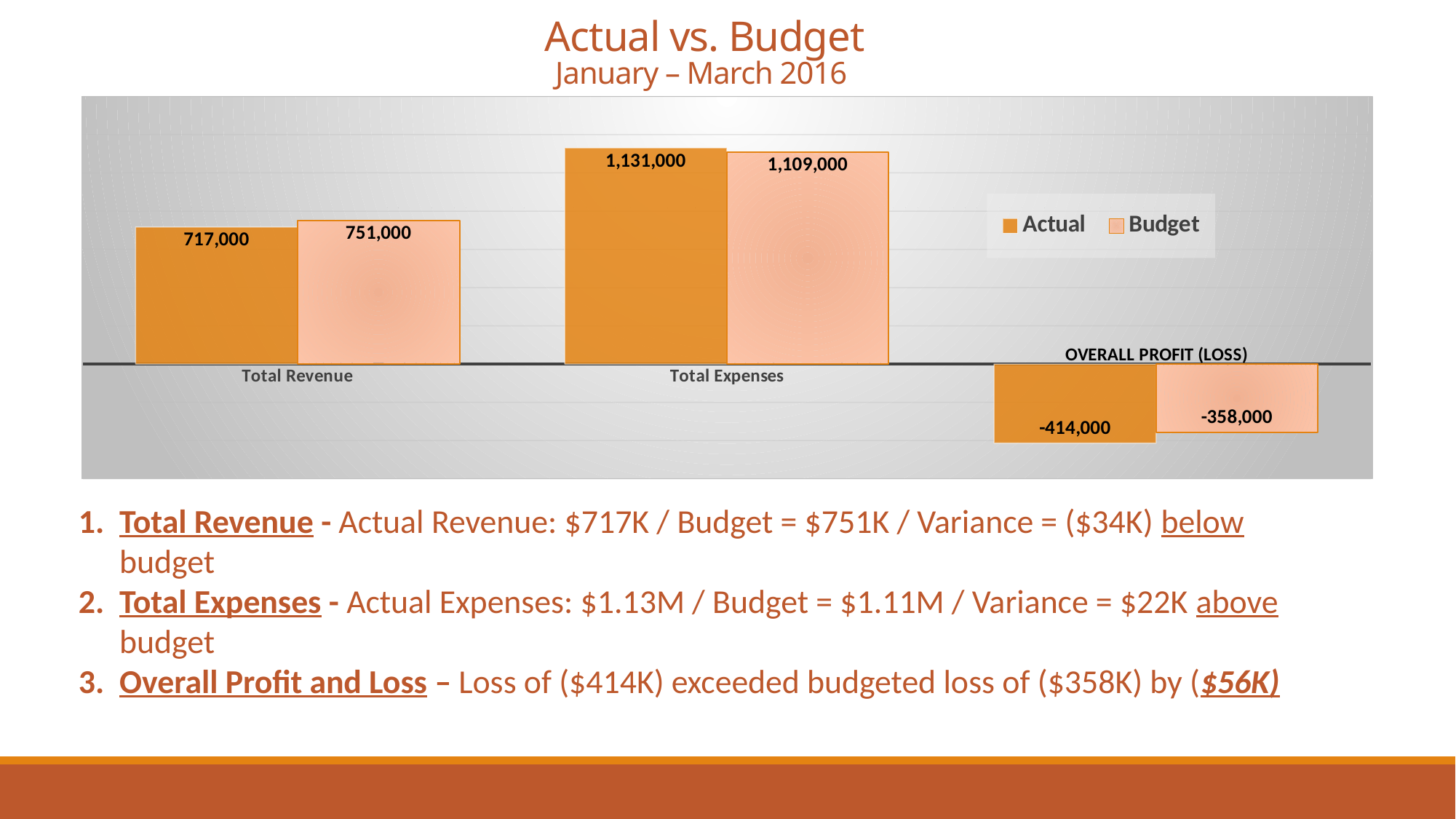
What is the Budget value for OVERALL PROFIT (LOSS)? -358,000 Which category has the highest Actual value? Total Expenses What is the Actual value for OVERALL PROFIT (LOSS)? -414,000 What is the Budget value for Total Expenses? 1,109,000 For Total Revenue, which is larger: the Actual value or the Budget value? Budget Which category has the lowest Budget value? OVERALL PROFIT (LOSS) What is the Actual value for Total Revenue? 717,000 What is the difference between the Actual and Budget values for Total Expenses? 22,000 What is the difference between the Budget and Actual values for Total Revenue? 34,000 How many categories are shown on the x axis? 3 What kind of chart is shown on the slide? Bar chart How many series does the legend list? 2